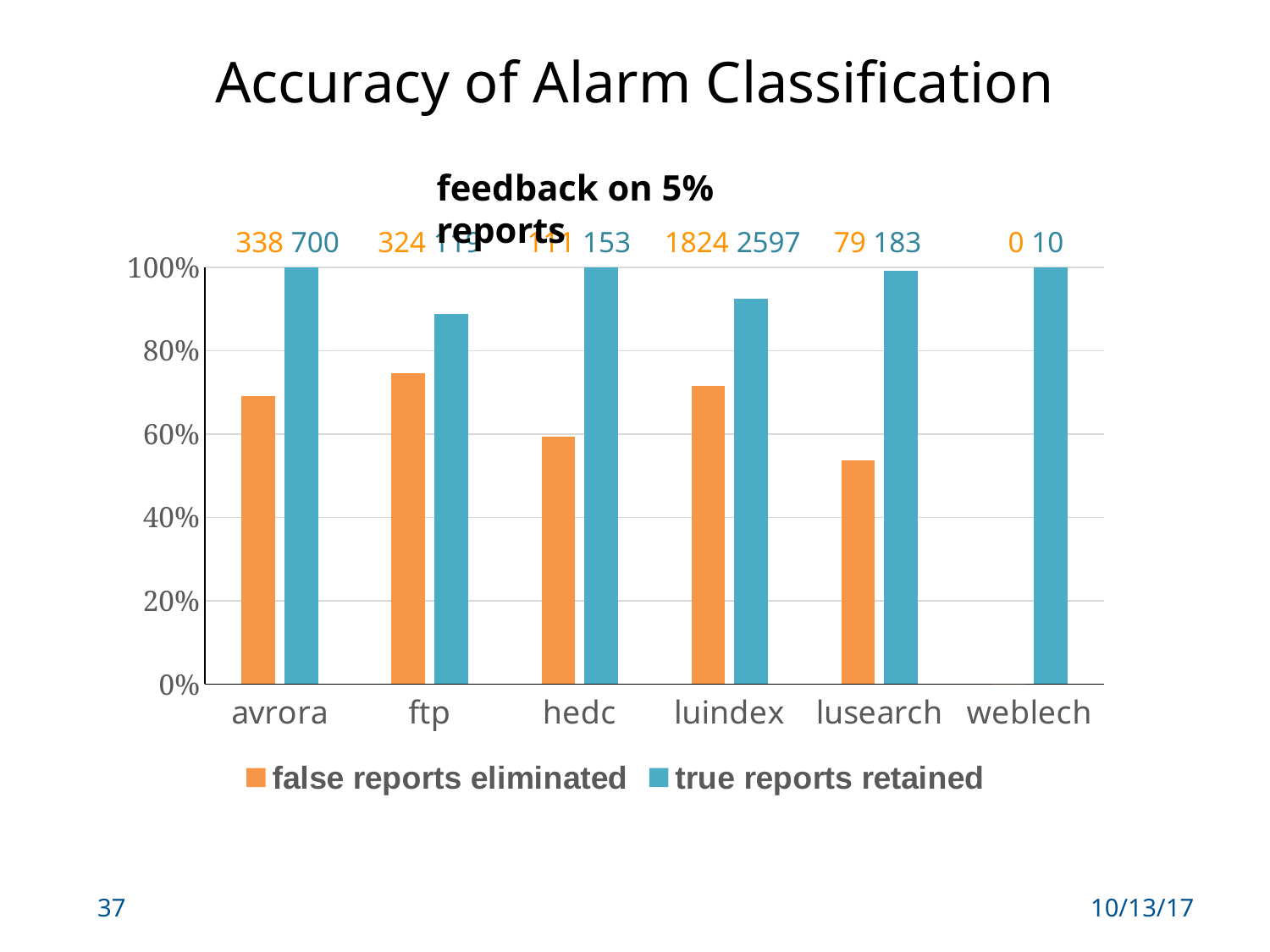
Is the value of 'false reports eliminated' for avrora greater or less than 60%? greater Is the value of 'true reports retained' for ftp greater or less than 80%? greater What two numbers are printed above the bars for avrora? 338 700 How many categories are shown on the x axis of the chart? 6 Is the value of 'false reports eliminated' for lusearch greater or less than 60%? less Which series is shown in orange in the chart? false reports eliminated Which is larger, 'false reports eliminated' for luindex or for lusearch? luindex Which is larger, 'true reports retained' for avrora or for ftp? avrora What kind of chart is shown on the slide? bar chart How many series does the chart's legend list? 2 Which is larger, 'false reports eliminated' for ftp or for hedc? ftp